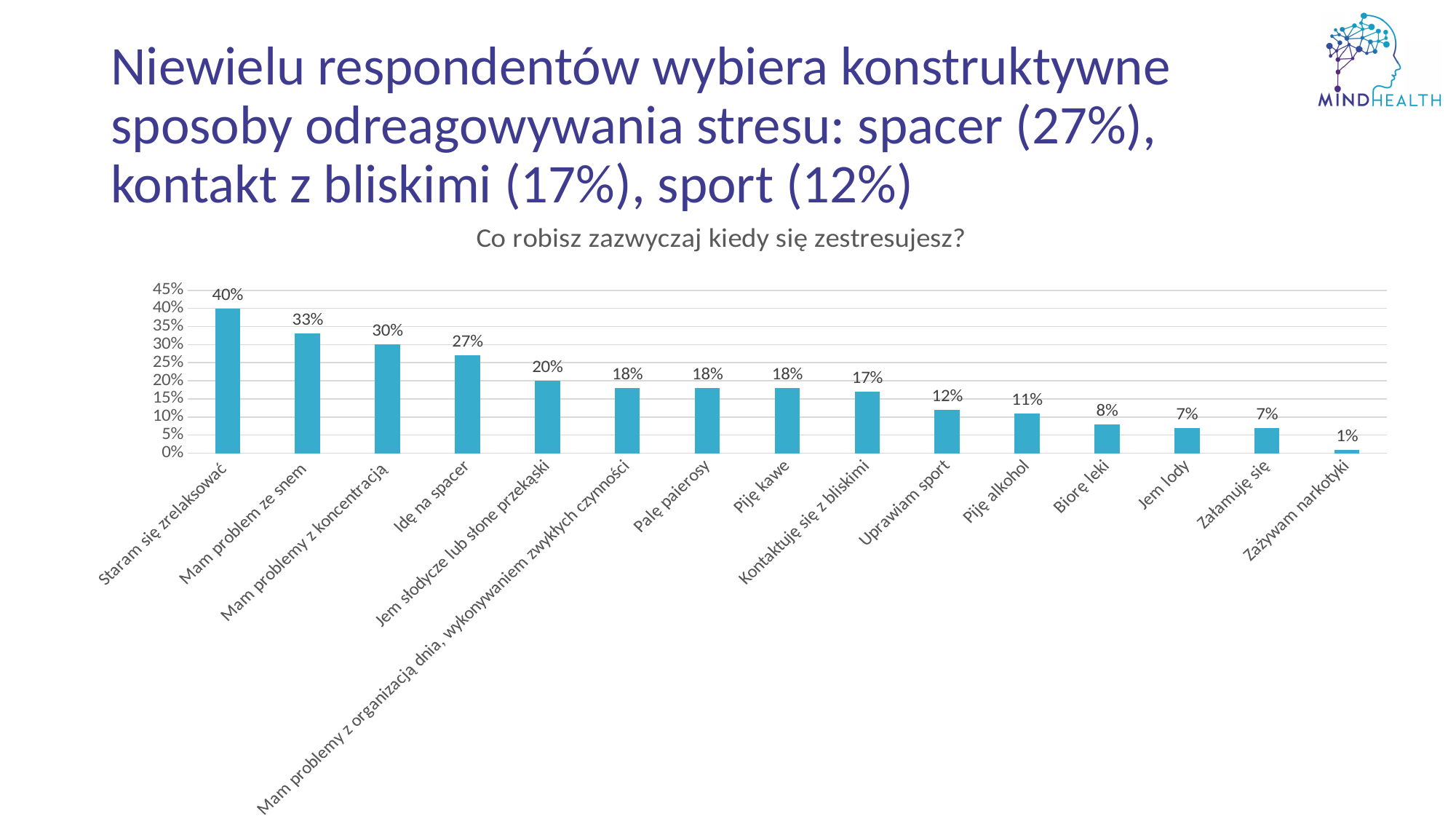
How many categories are shown in the chart? 15 What is the difference between "Mam problemy z koncentracją" and "Kontaktuję się z bliskimi"? 13% Which is larger, "Jem słodycze lub słone przekąski" or "Biorę leki"? Jem słodycze lub słone przekąski What is the value for "Piję alkohol"? 11% Which category has the highest value? Staram się zrelaksować Is the value for "Piję kawę" greater or less than 15%? greater What is the value for "Mam problem ze snem"? 33% What is the title of the chart? Co robisz zazwyczaj kiedy się zestresujesz? What kind of chart is shown on the slide? bar chart What is the value for "Idę na spacer"? 27% What is the difference between "Staram się zrelaksować" and "Uprawiam sport"? 28% Which category has the lowest value? Zażywam narkotyki